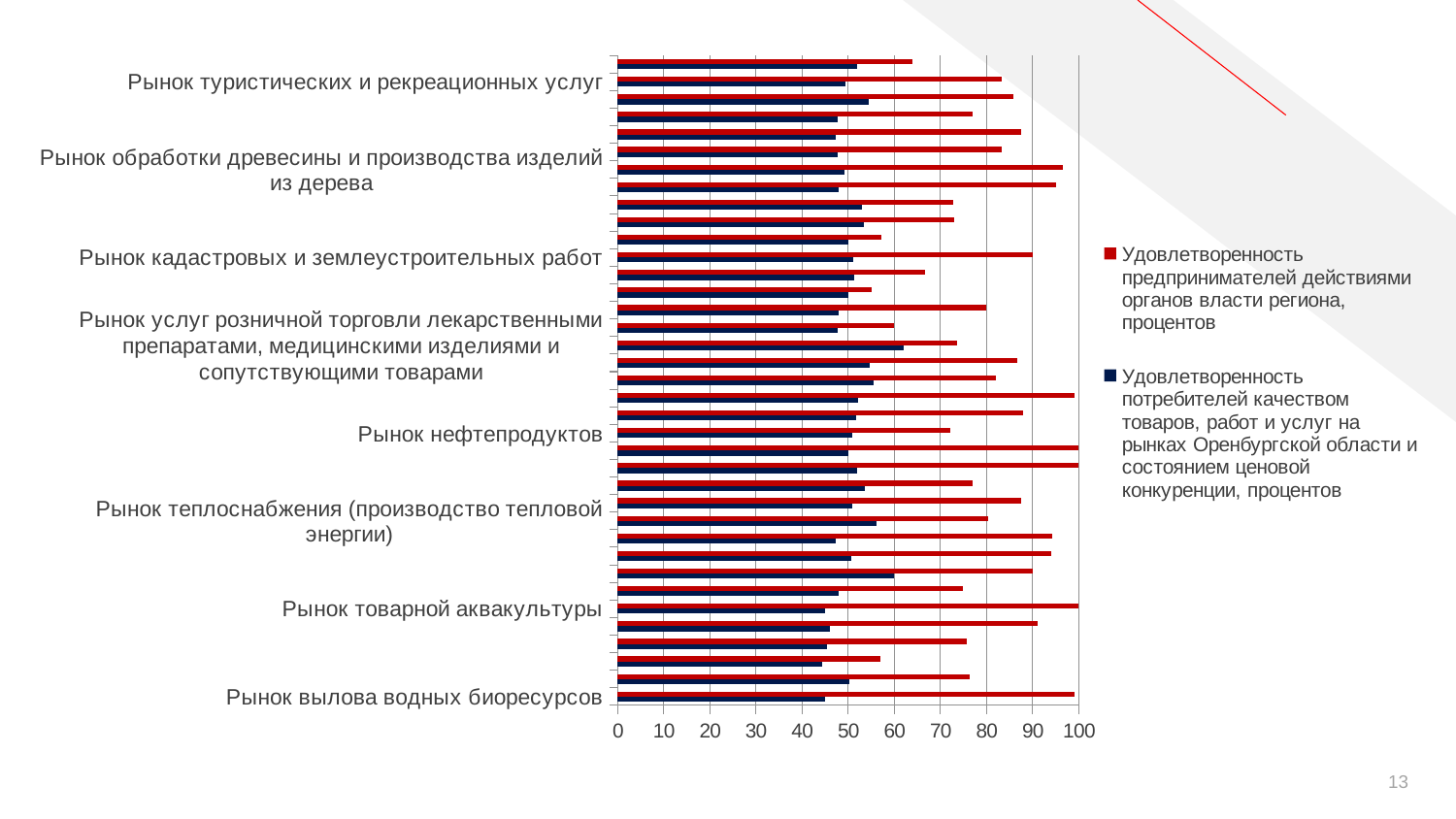
Is the value of 'Удовлетворенность потребителей качеством товаров, работ и услуг' for 'Рынок вылова водных биоресурсов' greater or less than 50? less Is the value of 'Удовлетворенность потребителей качеством товаров, работ и услуг' for 'Рынок нефтепродуктов' greater or less than 60? less Is the value of 'Удовлетворенность предпринимателей действиями органов власти региона' for 'Рынок нефтепродуктов' greater or less than 60? greater How many series does the legend list? 2 Which colour represents the series 'Удовлетворенность предпринимателей действиями органов власти региона, процентов'? red Which series is shown in dark blue? Удовлетворенность потребителей качеством товаров, работ и услуг на рынках Оренбургской области и состоянием ценовой конкуренции, процентов What kind of chart is shown on the slide? bar chart For 'Рынок вылова водных биоресурсов', which series has the larger value: satisfaction of entrepreneurs (red) or satisfaction of consumers (blue)? satisfaction of entrepreneurs (red)